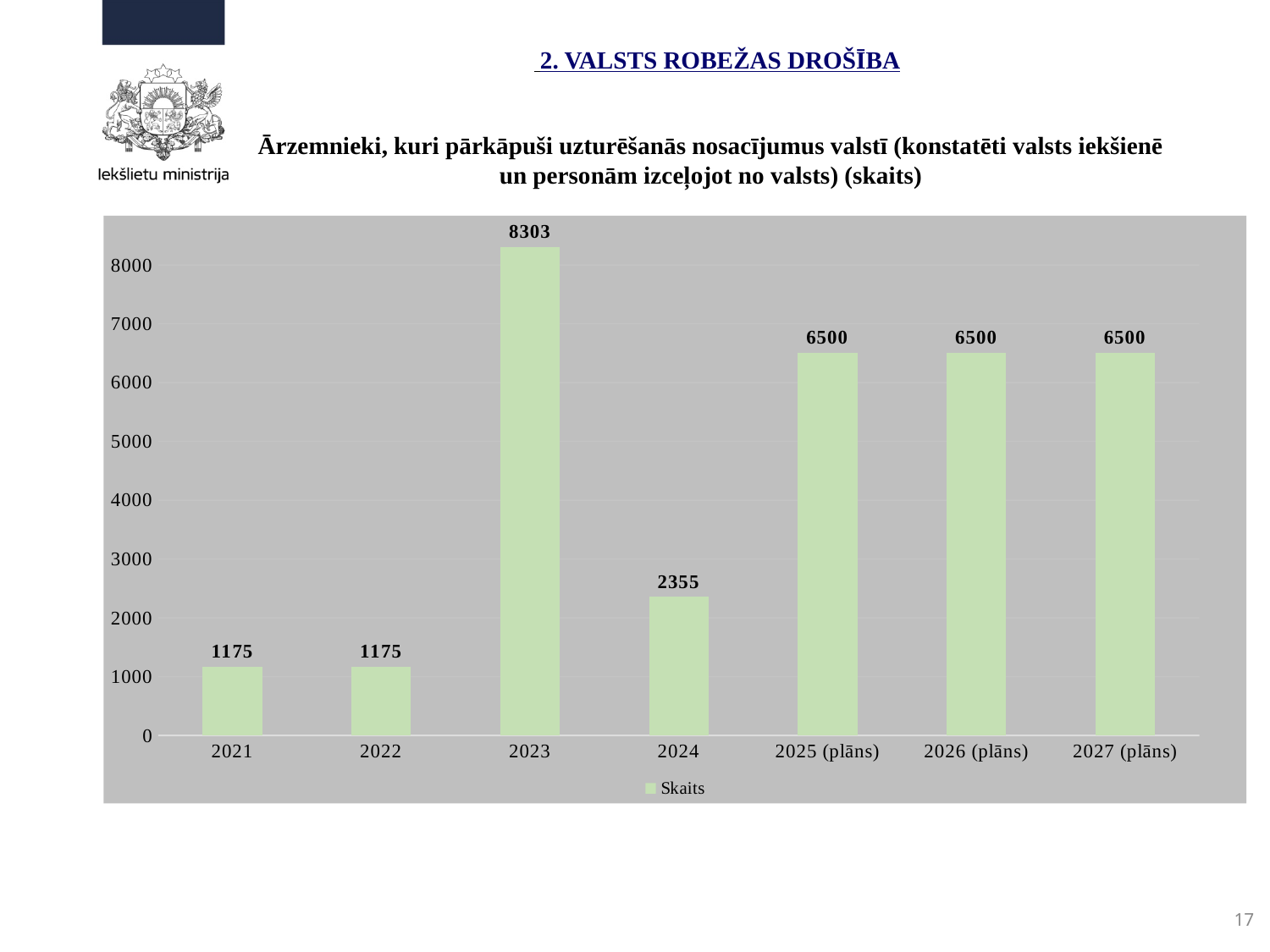
What series name is listed in the legend? Skaits Which year has the highest value? 2023 What is the value for 2024? 2355 What is the planned value for 2026 (plāns)? 6500 What kind of chart is shown on the slide? bar chart What is the value for 2021? 1175 What is the difference between the values for 2025 (plāns) and 2024? 4145 How many categories are shown on the x axis? 7 What is the value for 2023? 8303 Is the value for 2023 greater or less than 8000? greater What is the difference between the values for 2023 and 2024? 5948 Which is larger, the value for 2024 or the value for 2022? 2024